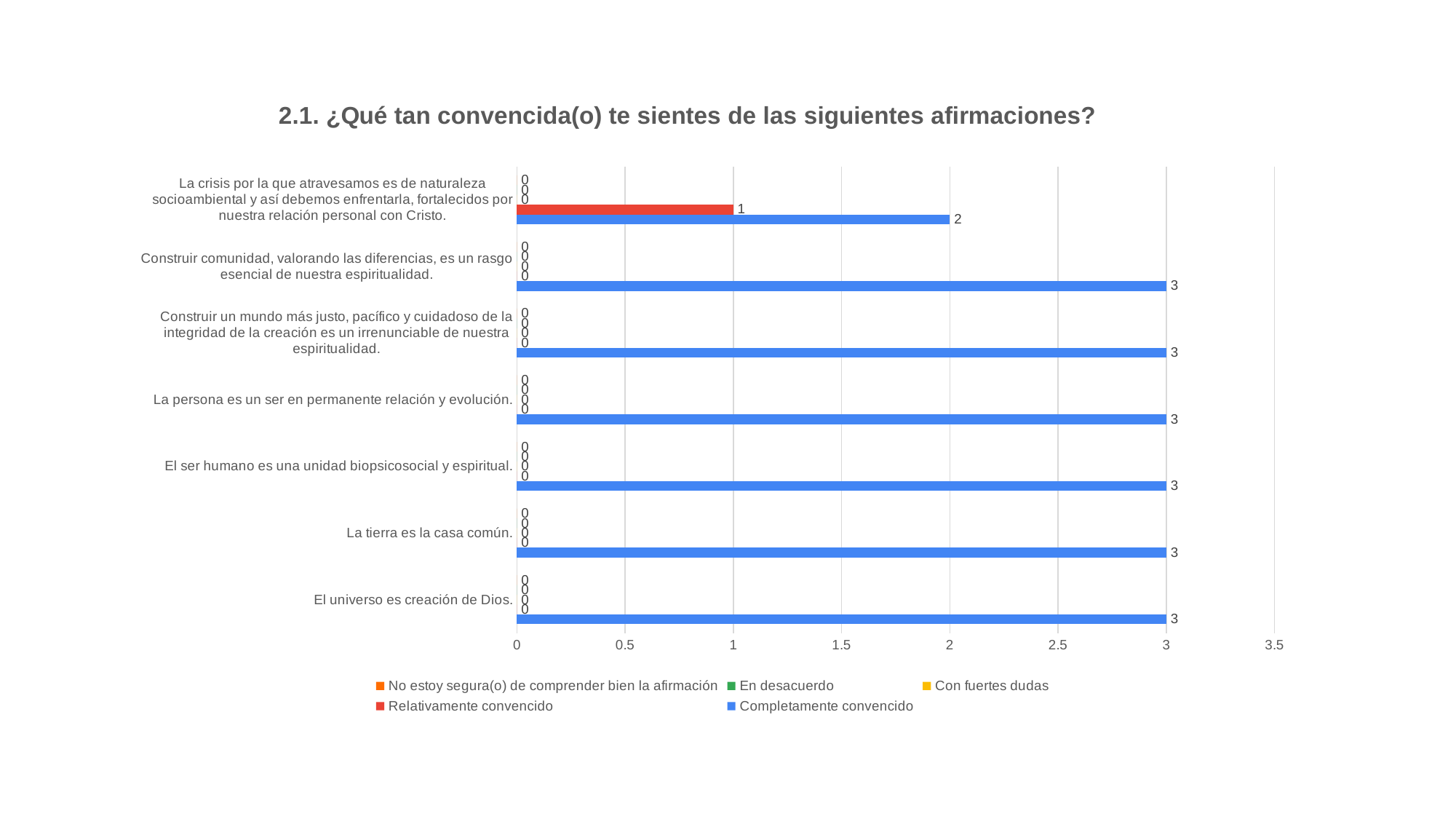
What is the value of "En desacuerdo" for "La tierra es la casa común."? 0 What is the total of all series for the statement "La crisis por la que atravesamos..."? 3 What kind of chart is shown on the slide? Bar chart What is the value of "Completamente convencido" for the statement "La crisis por la que atravesamos es de naturaleza socioambiental..."? 2 For the statement "La crisis por la que atravesamos...", which is larger: "Relativamente convencido" or "Completamente convencido"? Completamente convencido How many series does the legend list? 5 Which statement has the lowest "Completamente convencido" value? La crisis por la que atravesamos es de naturaleza socioambiental y así debemos enfrentarla, fortalecidos por nuestra relación personal con Cristo. What is the value of "Completamente convencido" for "El universo es creación de Dios."? 3 What is the title of the chart? 2.1. ¿Qué tan convencida(o) te sientes de las siguientes afirmaciones? What is the difference between the "Completamente convencido" value for "La tierra es la casa común." and for the statement about "La crisis por la que atravesamos..."? 1 What is the value of "Relativamente convencido" for the statement "La crisis por la que atravesamos es de naturaleza socioambiental y así debemos enfrentarla, fortalecidos por nuestra relación personal con Cristo."? 1 How many statements (categories) are shown on the chart? 7